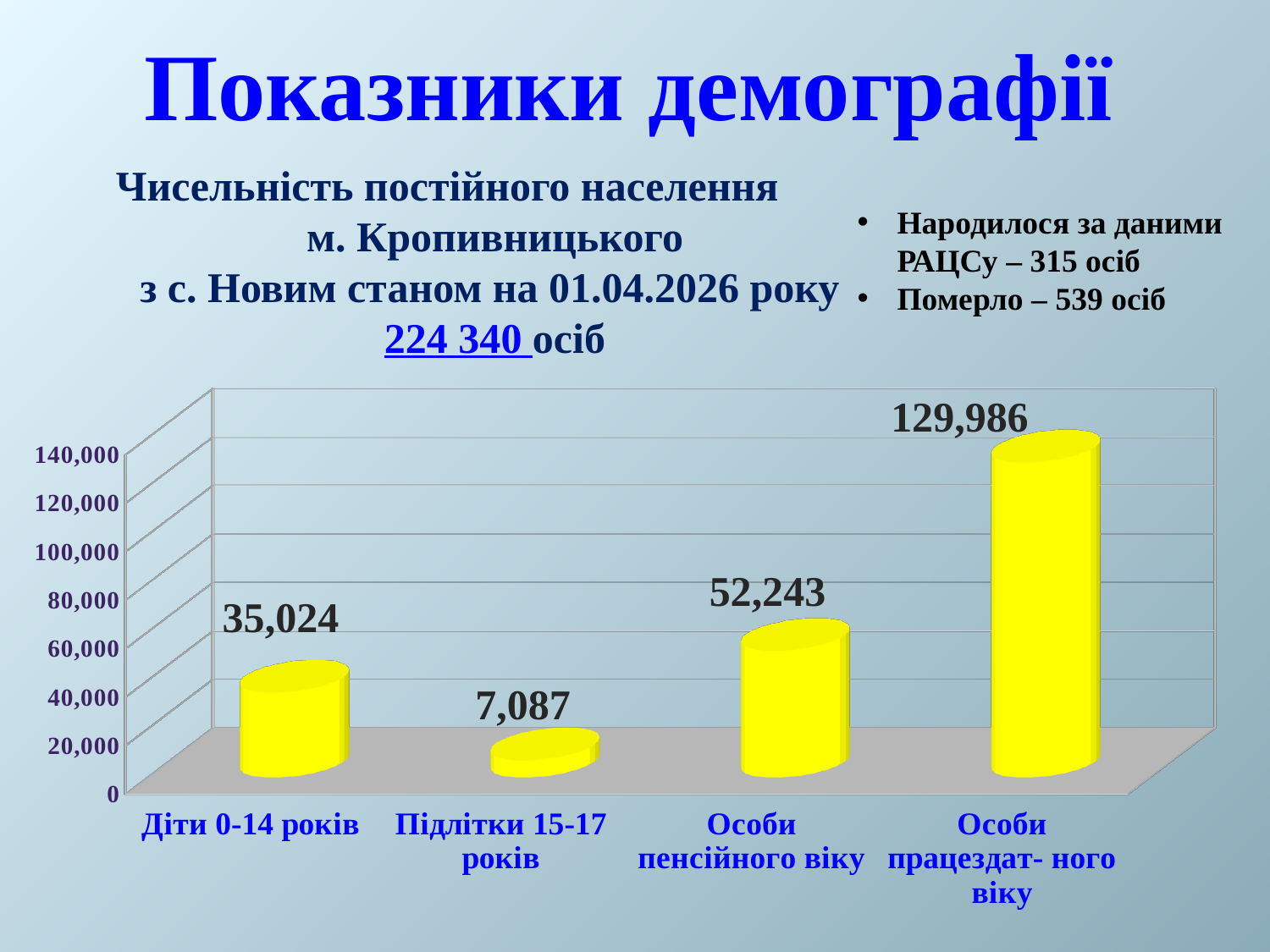
Is the value for Особи пенсійного віку greater or less than 40,000? greater What is the difference between the values for Особи працездатного віку and Особи пенсійного віку? 77,743 What is the value for Особи пенсійного віку? 52,243 Which category has the lowest value? Підлітки 15-17 років Which category has the highest value? Особи працездатного віку What kind of chart is shown on the slide? bar chart What is the value for Підлітки 15-17 років? 7,087 What is the value for Діти 0-14 років? 35,024 Which is larger, the value for Особи пенсійного віку or the value for Діти 0-14 років? Особи пенсійного віку What is the difference between the values for Діти 0-14 років and Підлітки 15-17 років? 27,937 What is the value for Особи працездатного віку? 129,986 How many categories are shown in the chart? 4